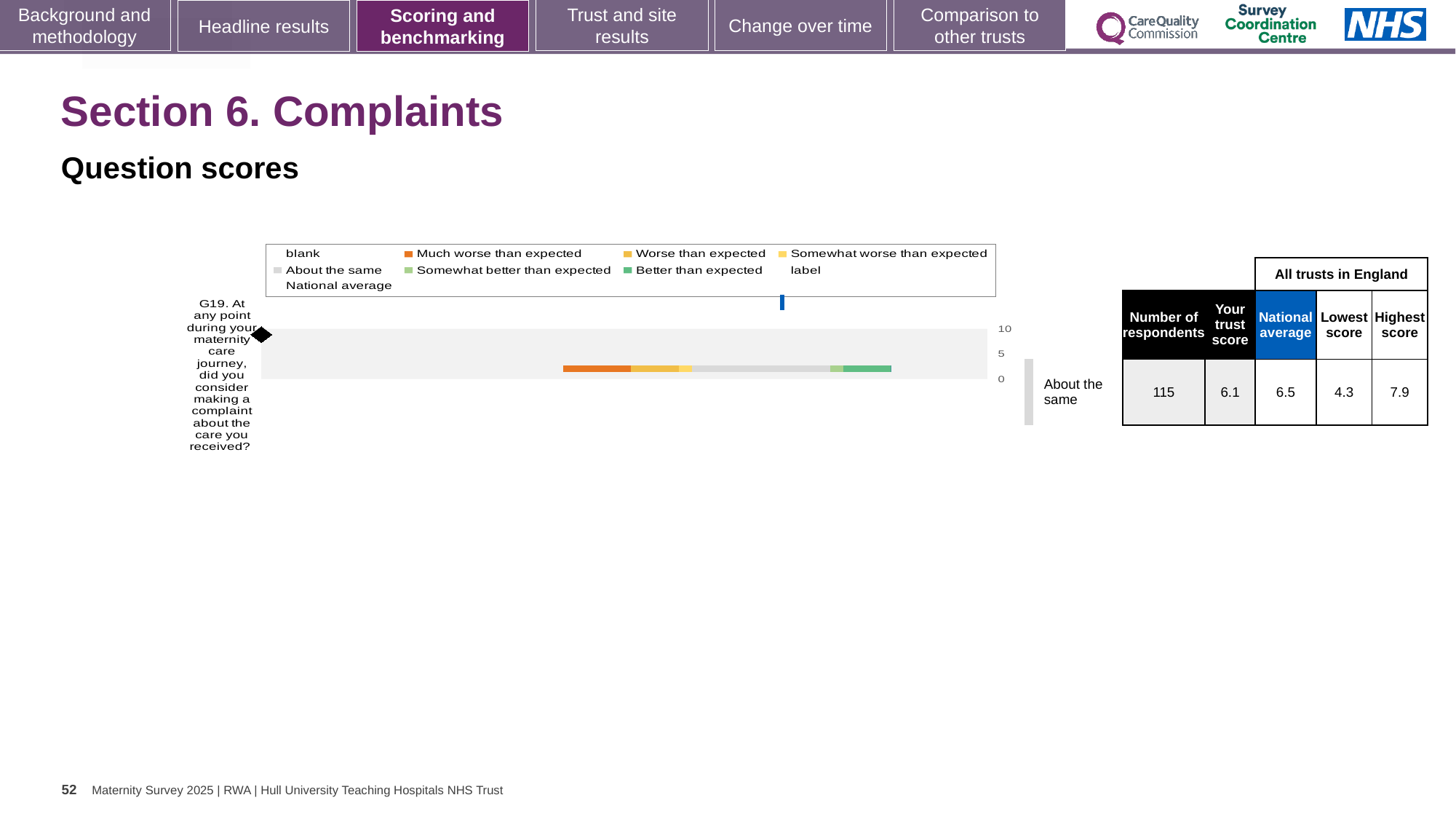
In the table next to the chart, what is the lowest score among all trusts in England for question G19? 4.3 What benchmark category is shown to the right of the chart for question G19? About the same In the table next to the chart, how many respondents answered question G19? 115 What is the difference between the highest score and the lowest score for question G19? 3.6 In the table next to the chart, what is the national average for question G19? 6.5 In the table next to the chart, what is the trust score for question G19? 6.1 What is the question code of the item plotted on the chart? G19 In the table next to the chart, what is the highest score among all trusts in England for question G19? 7.9 Which is larger for question G19, the trust score or the national average? National average What is the highest value shown on the chart's score axis? 10 What kind of chart is shown on the slide? Bar chart How many survey questions are plotted on the chart? 1